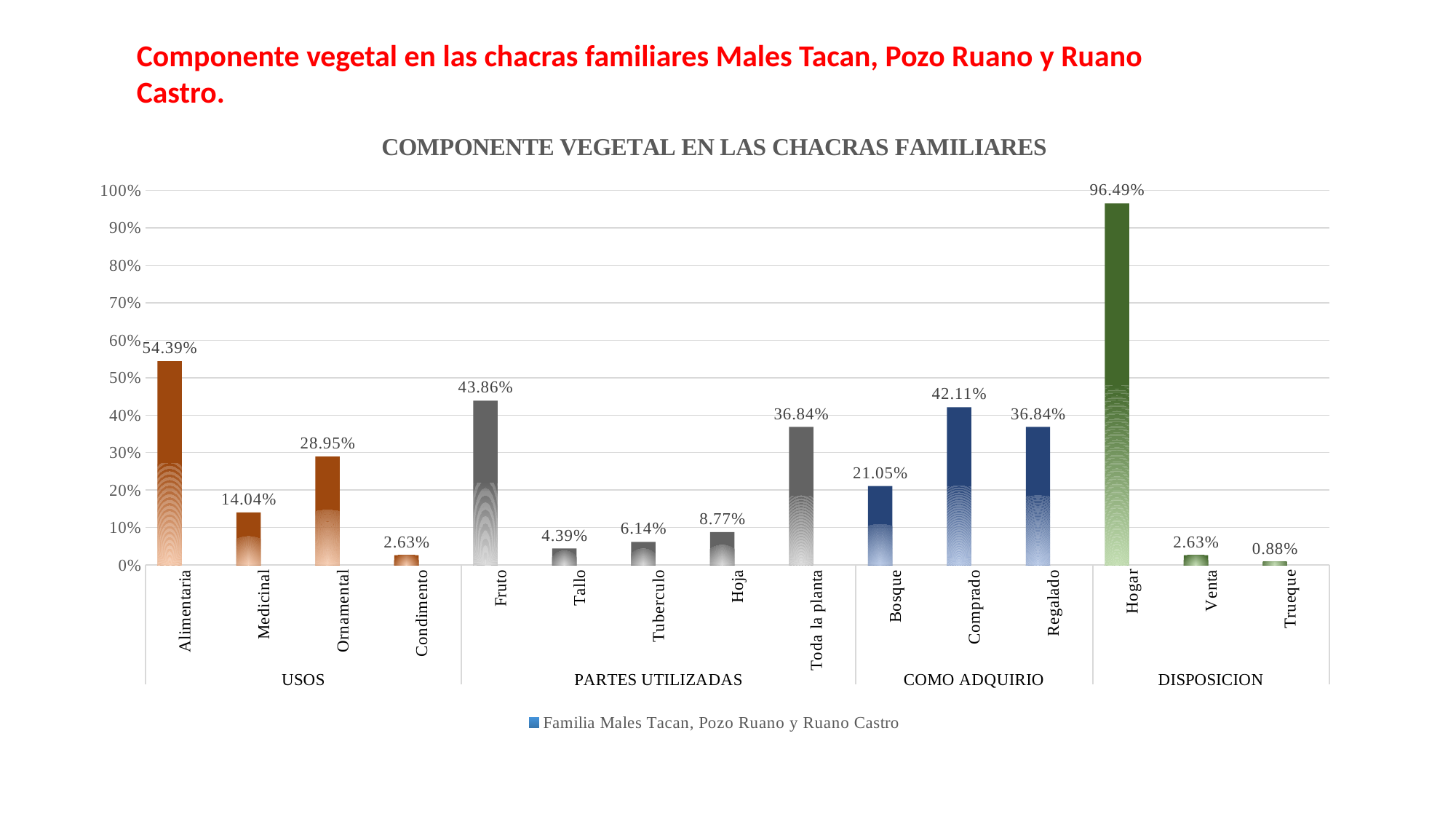
Which category has the highest value in the chart? Hogar Which category has the lowest value in the chart? Trueque What is the value for Comprado? 42.11% What is the difference between the values for Fruto and Tallo? 39.47% What kind of chart is shown on the slide? Bar chart How many categories are plotted in the chart? 15 What is the value for Tuberculo? 6.14% How many series does the legend list? 1 Which is larger, the value for Bosque or the value for Regalado? Regalado What is the value for Alimentaria? 54.39% What is the title of the chart? COMPONENTE VEGETAL EN LAS CHACRAS FAMILIARES What is the value for Hogar? 96.49%